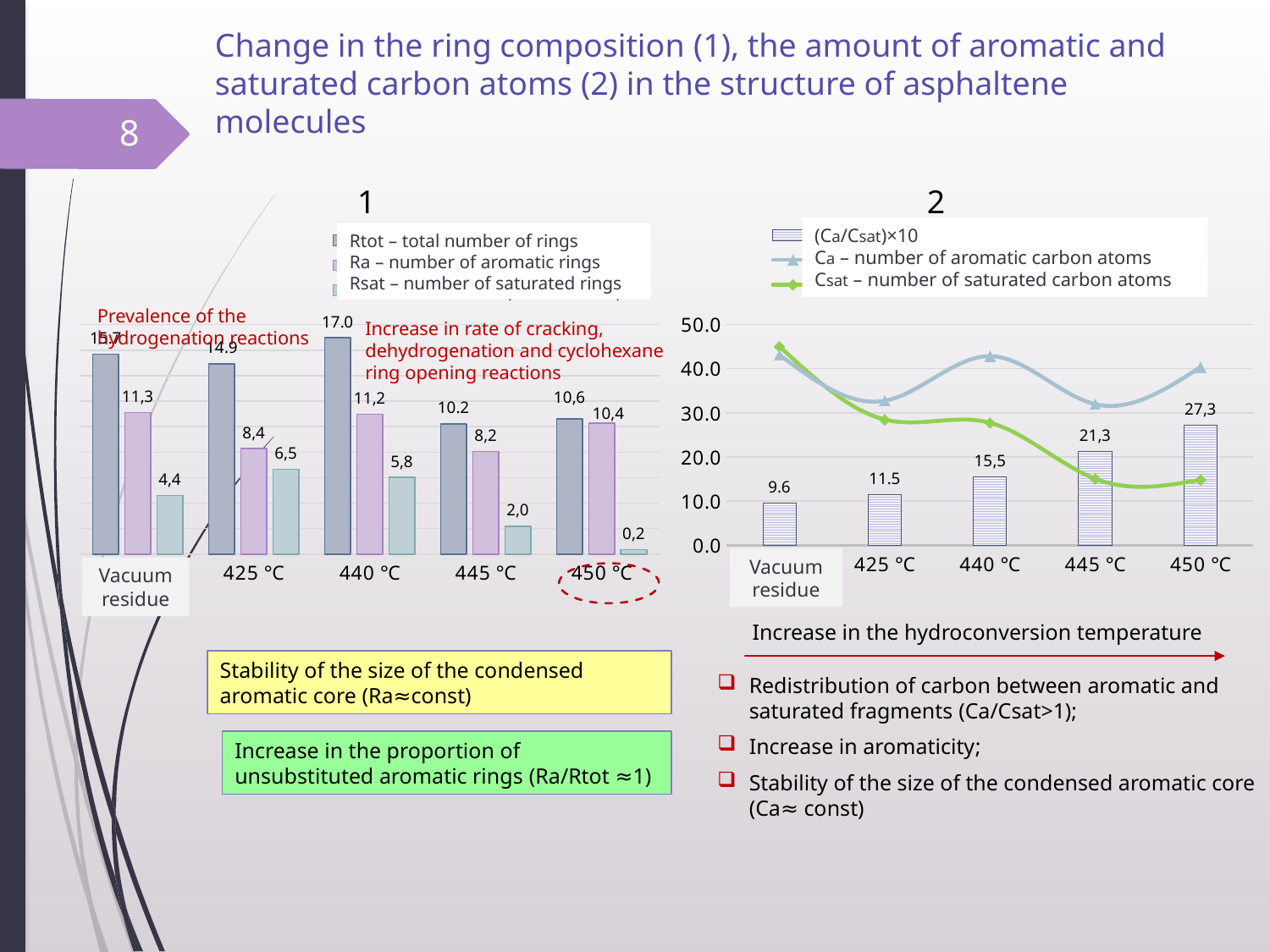
In chart 1 (left), what is the Rtot value at 440 °C? 17.0 In chart 1 (left), what is the difference between the Rsat values at 425 °C and 445 °C? 4,5 In chart 1 (left), what is the Ra value at 425 °C? 8,4 In chart 1 (left), how many categories are shown on the x axis? 5 In chart 2 (right), what is the (Ca/Csat)×10 value at 450 °C? 27,3 In chart 1 (left), which category has the highest Rtot value? 440 °C In chart 1 (left), which category has the lowest Rsat value? 450 °C In chart 1 (left), what is the Rsat value at 450 °C? 0,2 In chart 2 (right), is the Csat value at 450 °C greater or less than 20.0? less In chart 2 (right), do the (Ca/Csat)×10 bars rise or fall from Vacuum residue to 450 °C? rise In chart 2 (right), what is the (Ca/Csat)×10 value for Vacuum residue? 9.6 In chart 2 (right), how many series does the legend list? 3